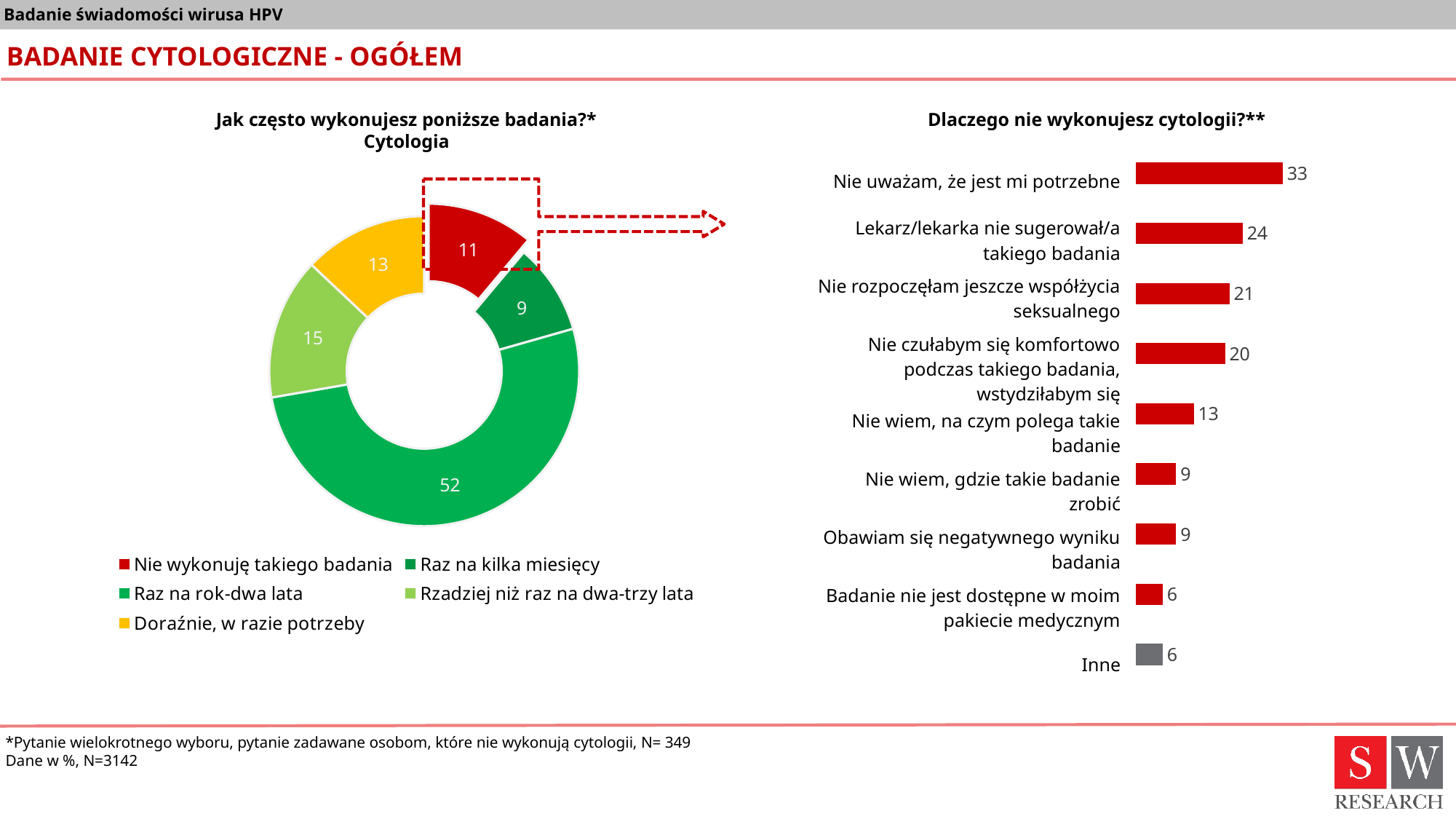
In the chart 'Dlaczego nie wykonujesz cytologii?**', what is the difference between 'Lekarz/lekarka nie sugerował/a takiego badania' and 'Nie rozpoczęłam jeszcze współżycia seksualnego'? 3 In the chart 'Dlaczego nie wykonujesz cytologii?**', what is the value for 'Nie wiem, na czym polega takie badanie'? 13 In the chart 'Dlaczego nie wykonujesz cytologii?**', what is the value for 'Nie uważam, że jest mi potrzebne'? 33 What kind of chart is 'Jak często wykonujesz poniższe badania?* Cytologia'? Pie (donut) chart In the chart 'Jak często wykonujesz poniższe badania?* Cytologia', what is the difference between 'Rzadziej niż raz na dwa-trzy lata' and 'Doraźnie, w razie potrzeby'? 2 In the chart 'Jak często wykonujesz poniższe badania?* Cytologia', which category has the smallest slice? Raz na kilka miesięcy In the chart 'Jak często wykonujesz poniższe badania?* Cytologia', what is the value for 'Raz na rok-dwa lata'? 52 In the chart 'Jak często wykonujesz poniższe badania?* Cytologia', what is the value for 'Nie wykonuję takiego badania'? 11 In the chart 'Dlaczego nie wykonujesz cytologii?**', which category has the highest value? Nie uważam, że jest mi potrzebne How many categories does the legend of the chart 'Jak często wykonujesz poniższe badania?* Cytologia' list? 5 How many bars are shown in the chart 'Dlaczego nie wykonujesz cytologii?**'? 9 In the chart 'Dlaczego nie wykonujesz cytologii?**', which is larger: 'Nie czułabym się komfortowo podczas takiego badania, wstydziłabym się' or 'Nie wiem, gdzie takie badanie zrobić'? Nie czułabym się komfortowo podczas takiego badania, wstydziłabym się